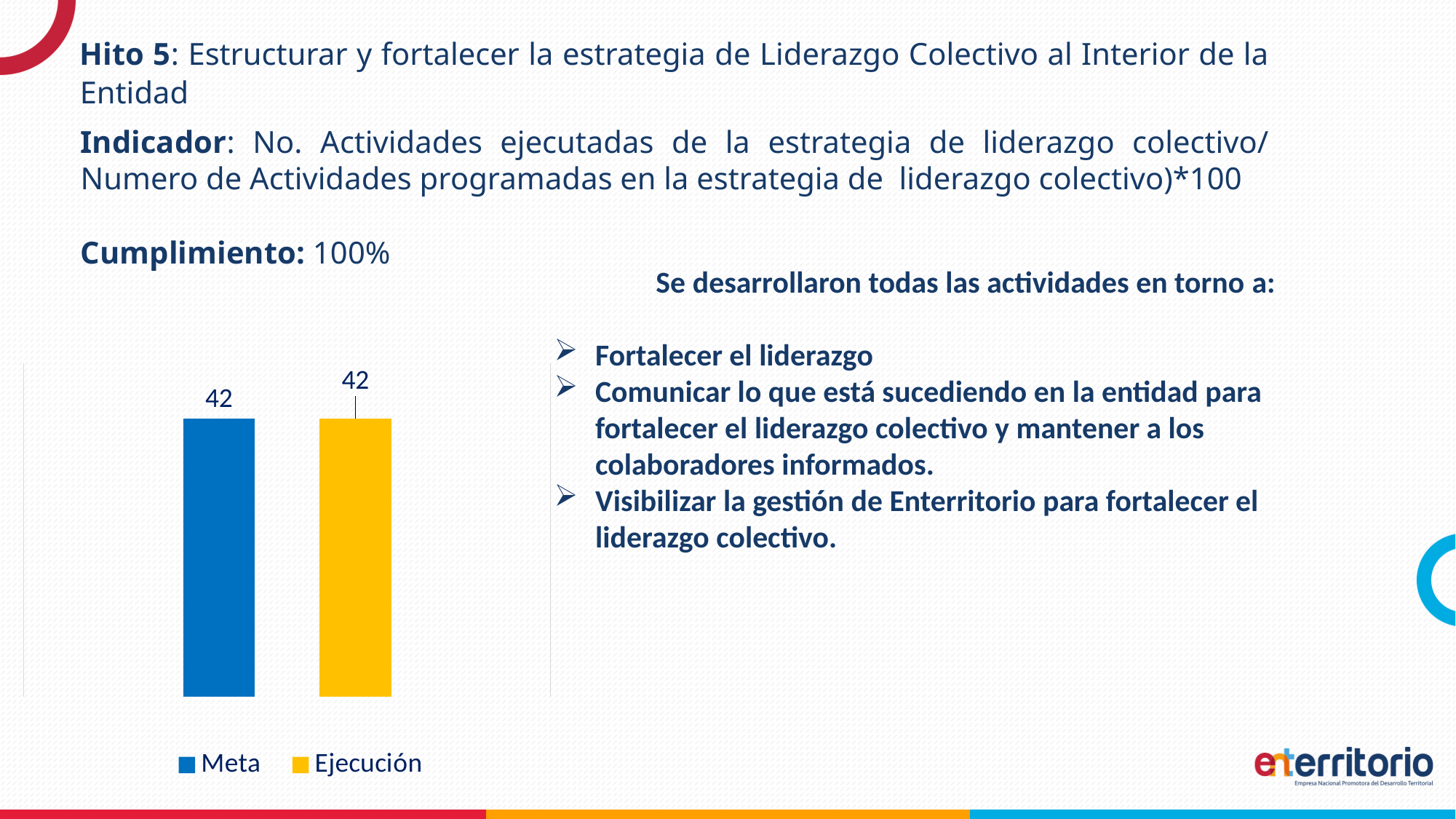
Is the value for Meta greater or less than 40? greater What is the total of the Meta and Ejecución values? 84 How many bars are plotted in the chart? 2 Which legend entry is shown in yellow? Ejecución What is the value of the Ejecución bar? 42 What is the value of the Meta bar? 42 What is the difference between the Ejecución value and the Meta value? 0 Which legend entry is shown in blue? Meta How many series does the legend list? 2 What kind of chart is shown on the slide? bar chart